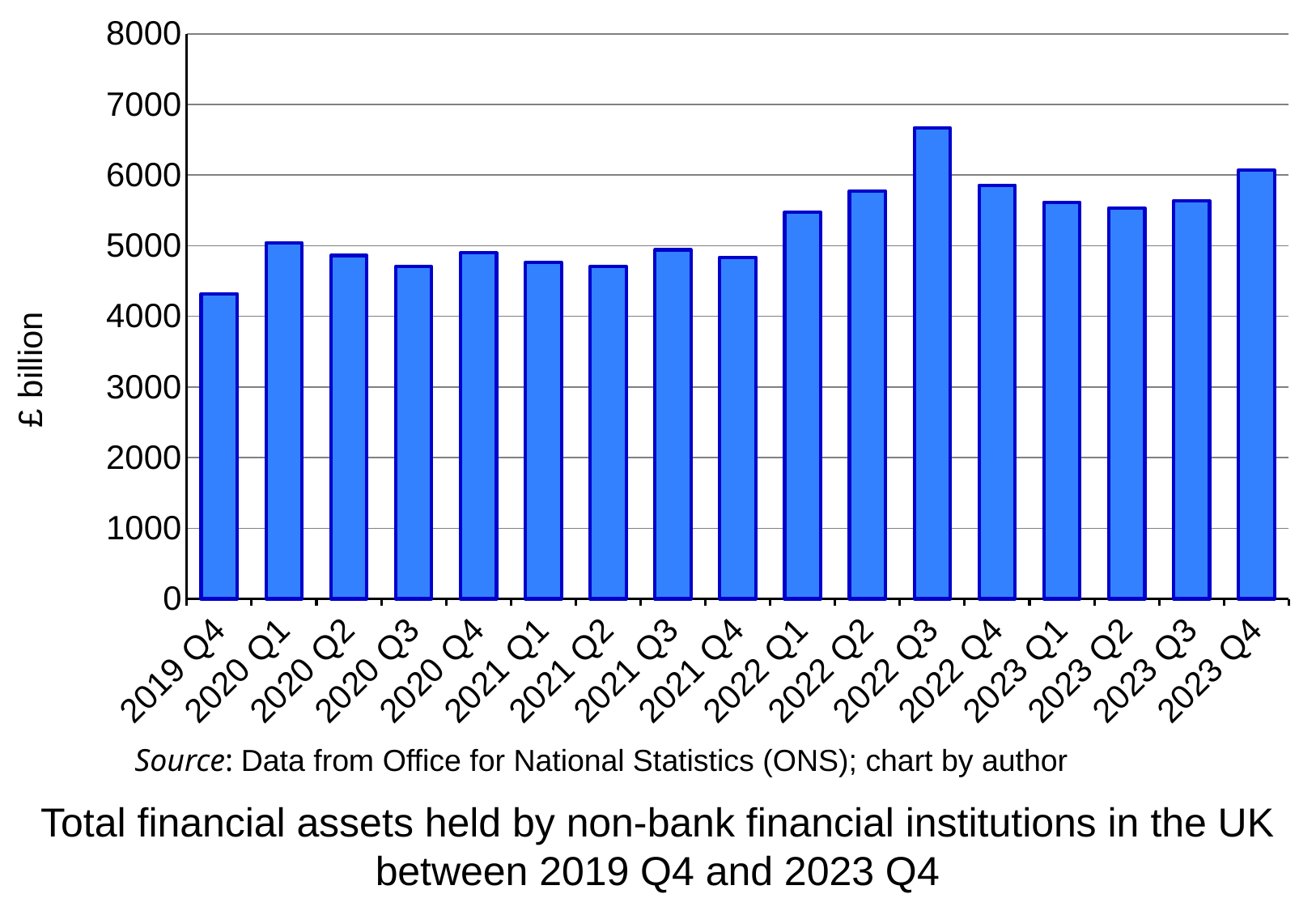
How many quarters are plotted on the chart? 17 What kind of chart is shown on the slide? bar chart Which is larger, the value for 2021 Q4 or the value for 2022 Q1? 2022 Q1 Is the value for 2022 Q3 greater or less than 6000? greater Which quarter has the lowest value of total financial assets? 2019 Q4 Which quarter has the highest value of total financial assets? 2022 Q3 Which is larger, the value for 2022 Q3 or the value for 2023 Q4? 2022 Q3 Overall, do the values rise or fall from 2019 Q4 to 2023 Q4? rise Is the value for 2022 Q2 greater or less than 6000? less Is the value for 2019 Q4 greater or less than 5000? less What is the label on the vertical axis? £ billion